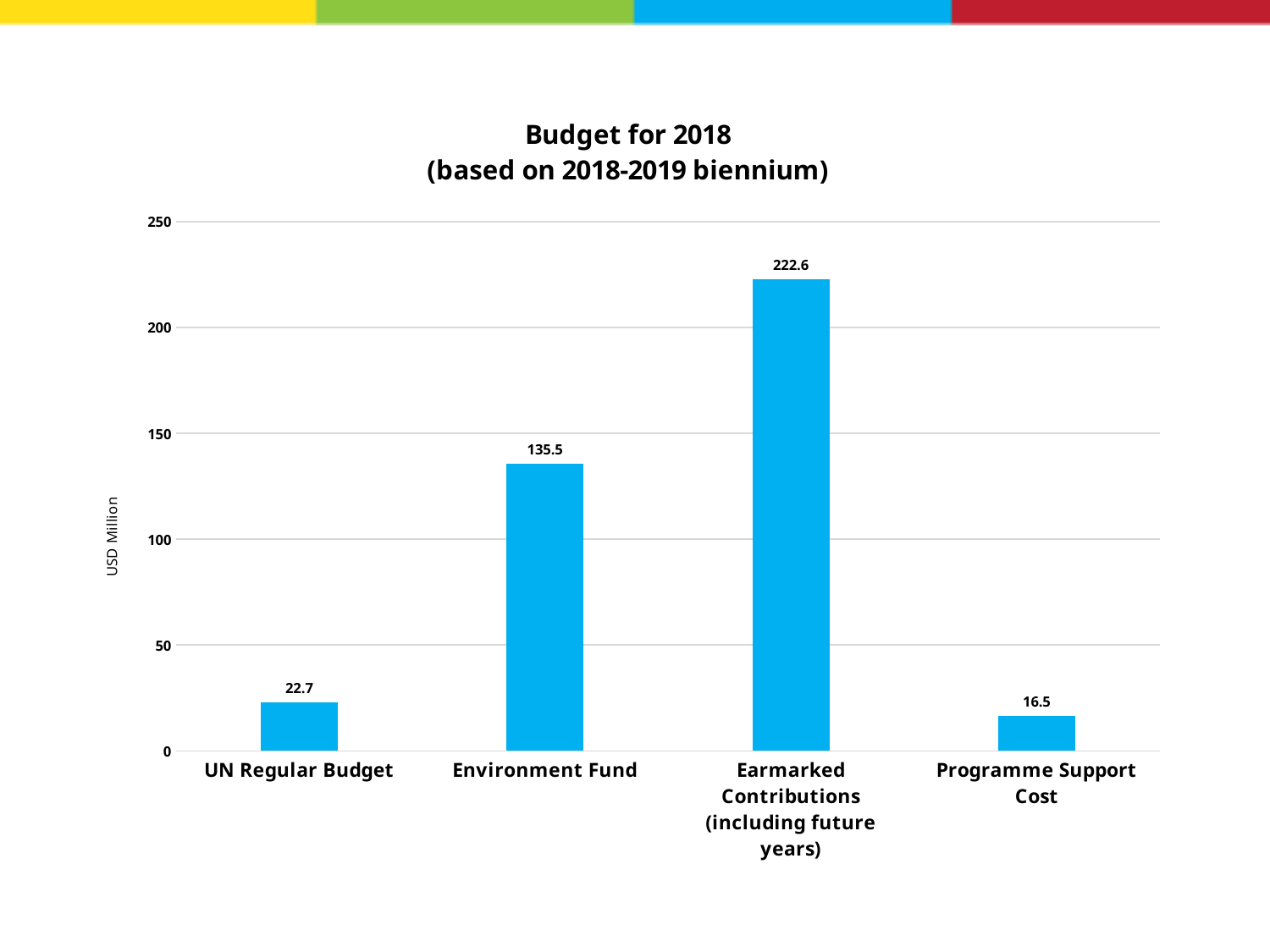
Which category has the highest value? Earmarked Contributions (including future years) Which category has the lowest value? Programme Support Cost How many categories are shown on the x axis? 4 What is the value for Environment Fund? 135.5 What is the value for Programme Support Cost? 16.5 What is the value for UN Regular Budget? 22.7 What kind of chart is this? bar chart Is the value for Environment Fund greater or less than 150? less What is the difference between Earmarked Contributions (including future years) and Environment Fund? 87.1 What is the difference between UN Regular Budget and Programme Support Cost? 6.2 Which is larger, UN Regular Budget or Programme Support Cost? UN Regular Budget What is the label on the vertical axis? USD Million